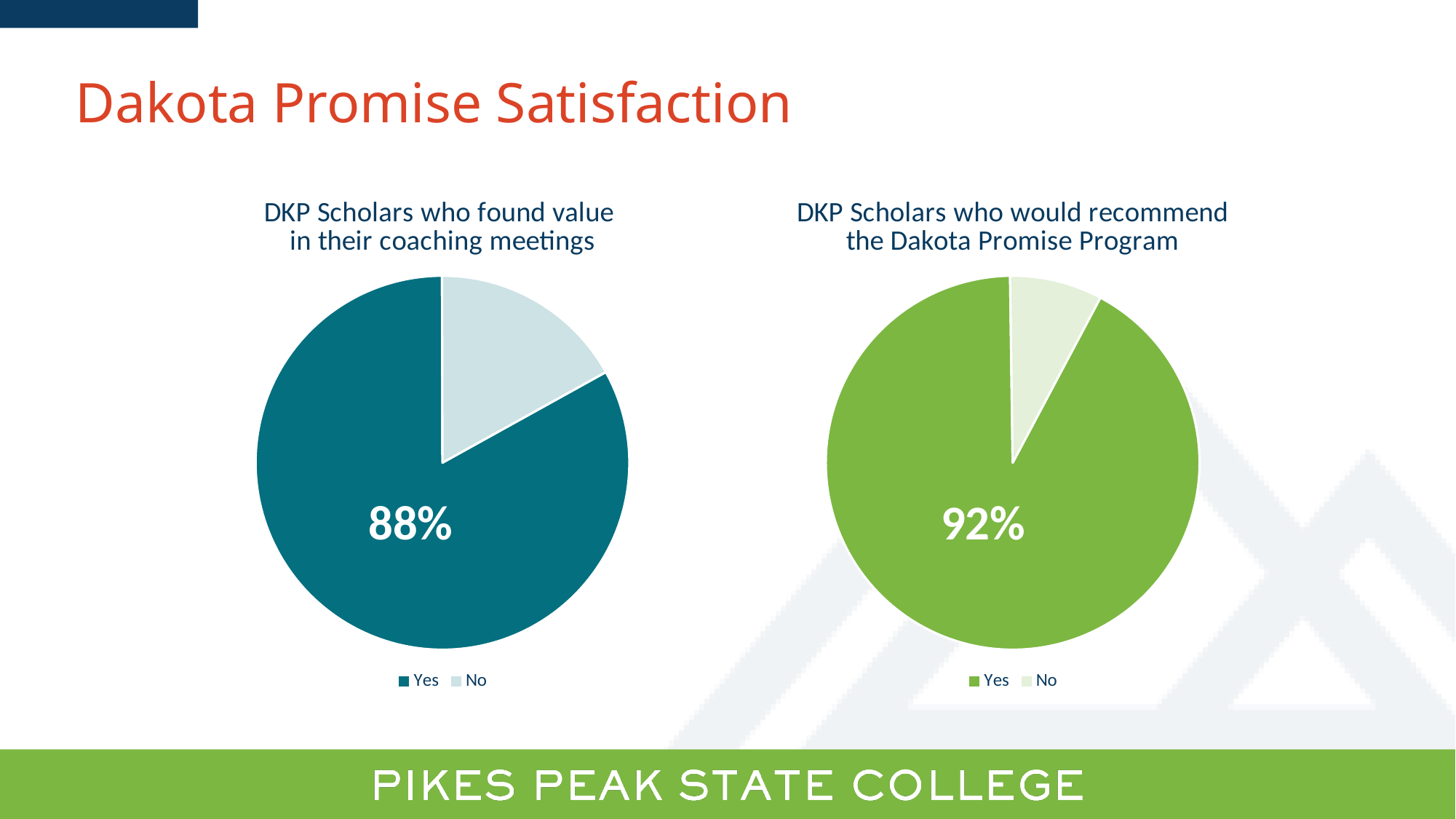
What are the two legend entries shown below the left pie chart? Yes and No In the left pie chart, 'DKP Scholars who found value in their coaching meetings', what percentage is shown for the Yes slice? 88% In the left pie chart, which slice is larger, Yes or No? Yes In the right pie chart, which slice is the smallest? No What kind of chart is used for 'DKP Scholars who found value in their coaching meetings'? Pie chart What kind of chart is used for 'DKP Scholars who would recommend the Dakota Promise Program'? Pie chart What is the title of the slide containing the two pie charts? Dakota Promise Satisfaction How many slices does the left pie chart, 'DKP Scholars who found value in their coaching meetings', have? 2 How many entries does the legend of the right pie chart list? 2 In the right pie chart, 'DKP Scholars who would recommend the Dakota Promise Program', what percentage is shown for the Yes slice? 92% Which is larger: the Yes share in the left pie chart (coaching meetings) or the Yes share in the right pie chart (would recommend)? The right pie chart (would recommend) What is the difference between the Yes percentage in the right pie chart (92%) and the Yes percentage in the left pie chart (88%)? 4 percentage points